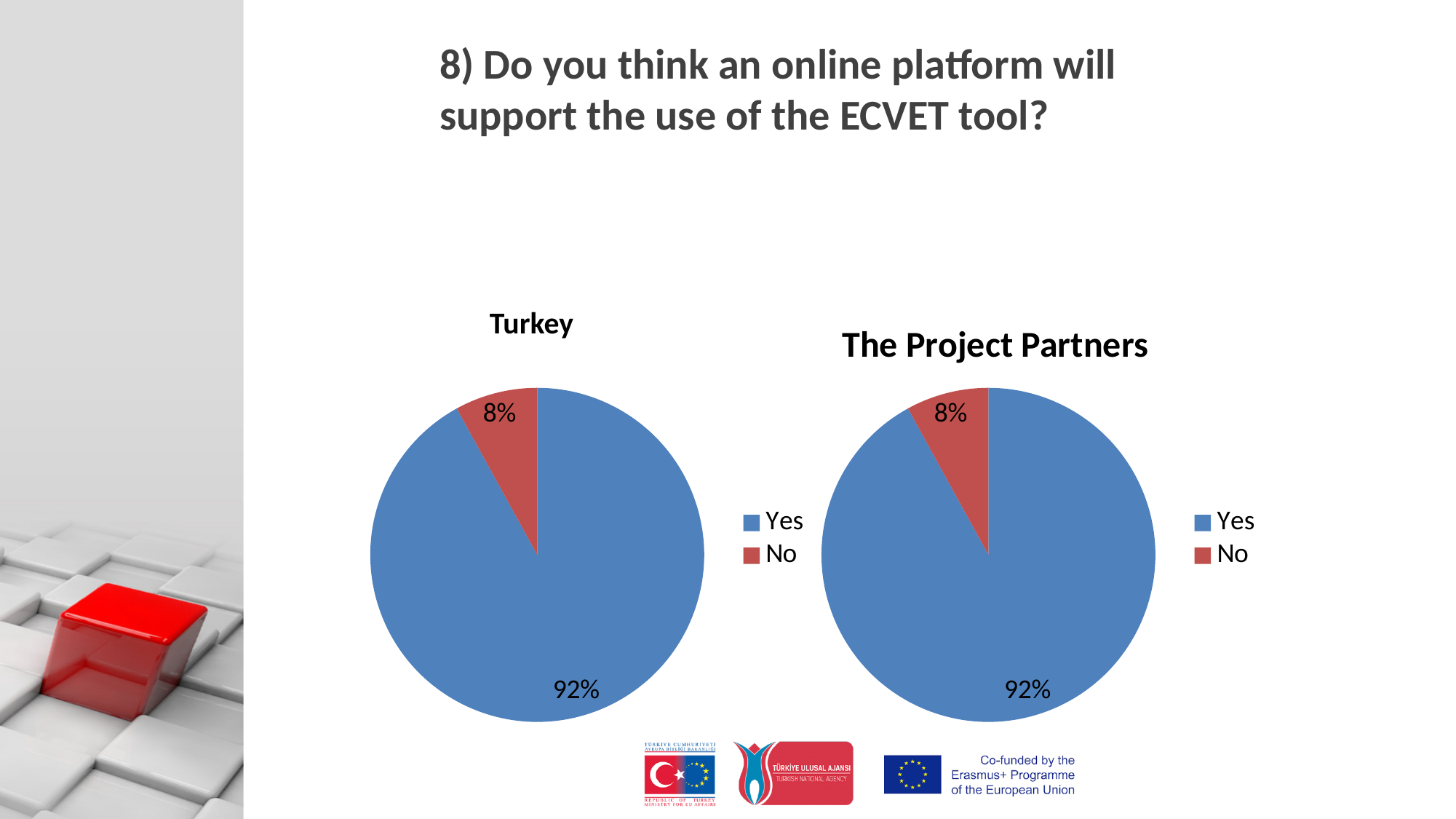
In 'The Project Partners' chart, what colour is the No slice? Red In the 'Turkey' chart, which response has the largest slice? Yes In 'The Project Partners' chart, is the Yes slice larger or smaller than the No slice? larger In 'The Project Partners' chart, which response has the smallest slice? No In the 'Turkey' chart, what percentage of respondents answered No? 8% In 'The Project Partners' chart, what percentage of respondents answered Yes? 92% In the 'Turkey' chart, what percentage of respondents answered Yes? 92% What type of chart is the 'Turkey' chart? Pie chart In 'The Project Partners' chart, what percentage of respondents answered No? 8% How many entries does the legend of the 'Turkey' chart list? 2 In the 'Turkey' chart, what is the difference in percentage points between the Yes and No slices? 84 How many slices does 'The Project Partners' chart have? 2